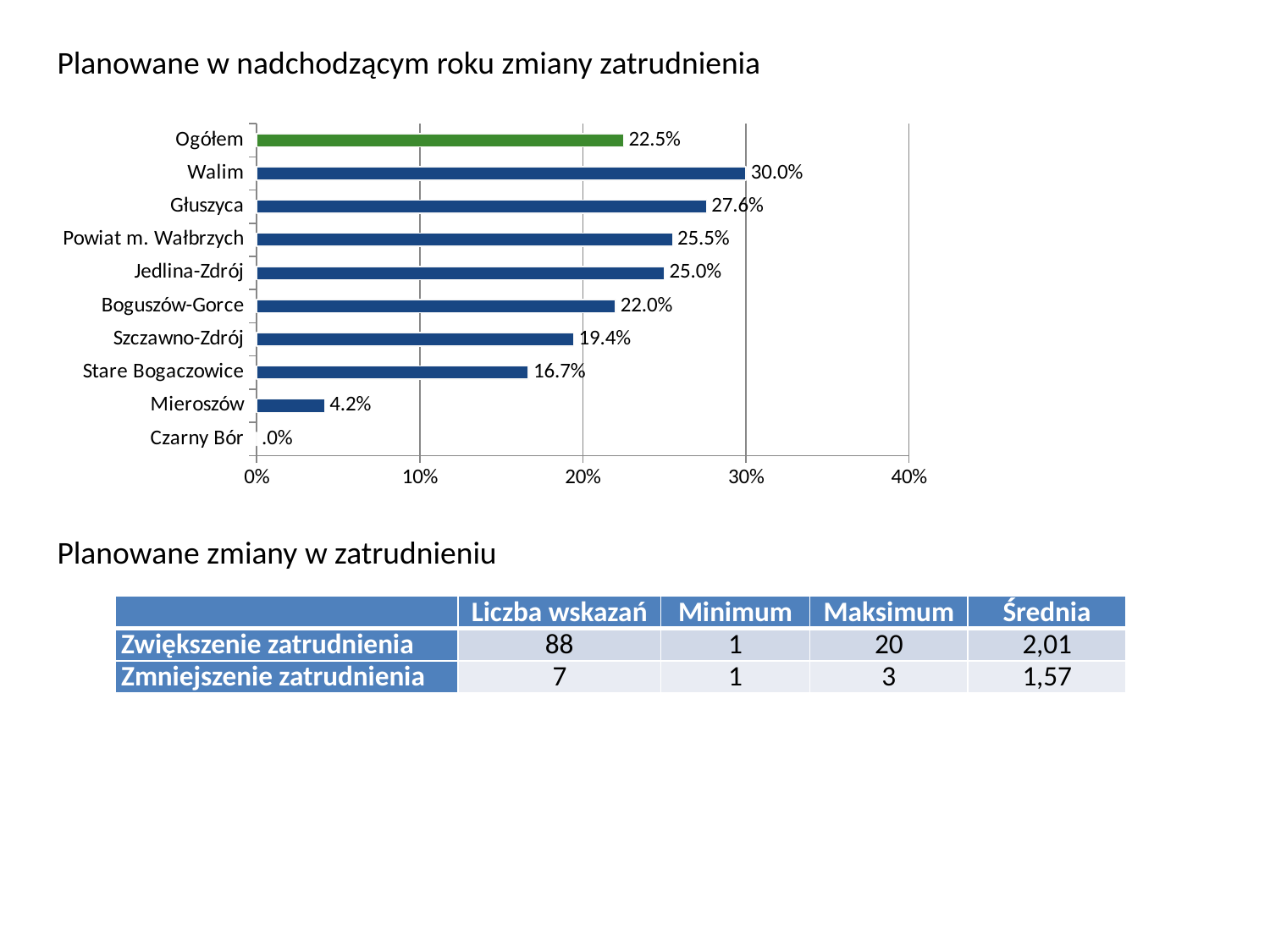
How many categories are shown on the chart? 10 What is the value for Walim? 30.0% Which category has the lowest value? Czarny Bór Is the value for Stare Bogaczowice greater or less than 20%? less What is the difference between the values for Walim and Głuszyca? 2.4% Which bar is shown in a different colour (green) from the others? Ogółem Which category has the highest value? Walim Which is larger, the value for Boguszów-Gorce or the value for Szczawno-Zdrój? Boguszów-Gorce What is the value for Ogółem? 22.5% What is the value for Mieroszów? 4.2% What is the value for Powiat m. Wałbrzych? 25.5% What kind of chart is shown on the slide? bar chart